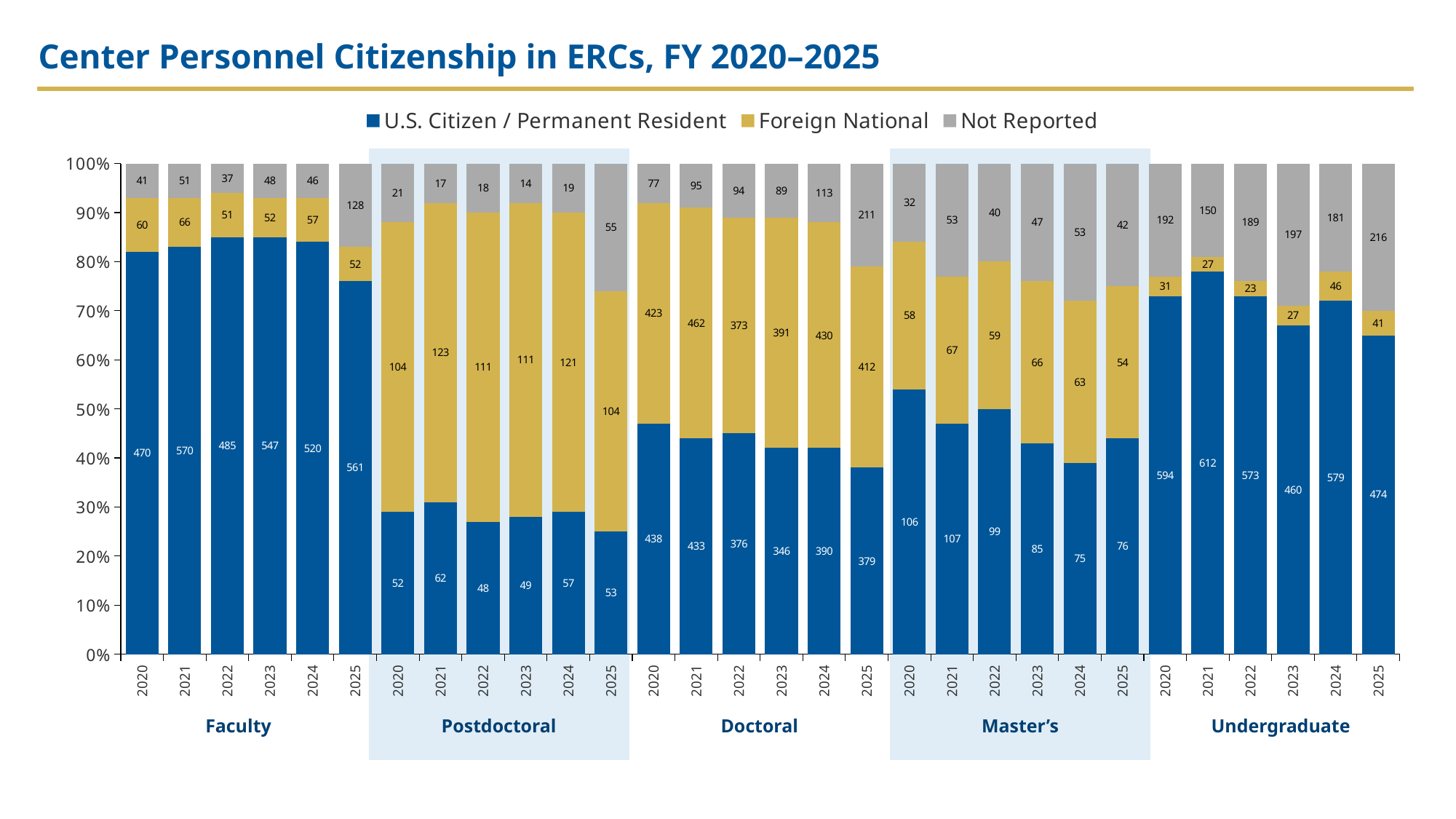
How many U.S. Citizen / Permanent Resident faculty personnel are shown for FY 2021? 570 How many series does the legend list? 3 What is the difference between the Doctoral Foreign National counts in FY 2021 and FY 2020? 39 What is the Foreign National count for Postdoctoral personnel in FY 2024? 121 What kind of chart is shown on the slide? 100% stacked bar chart Is the U.S. Citizen / Permanent Resident share of the Faculty bar for FY 2022 greater or less than 80%? greater Among the Faculty bars, which fiscal year has the highest U.S. Citizen / Permanent Resident count? 2021 How many personnel groups are labeled along the bottom of the chart? 5 What is the Not Reported count for Undergraduate personnel in FY 2025? 216 What is the total number of Master's personnel in FY 2020 across all three citizenship categories? 196 Which is larger: the Doctoral U.S. Citizen / Permanent Resident count in FY 2020 or the Doctoral Foreign National count in FY 2020? U.S. Citizen / Permanent Resident (438) Among the Master's bars, which fiscal year has the lowest U.S. Citizen / Permanent Resident count? 2024